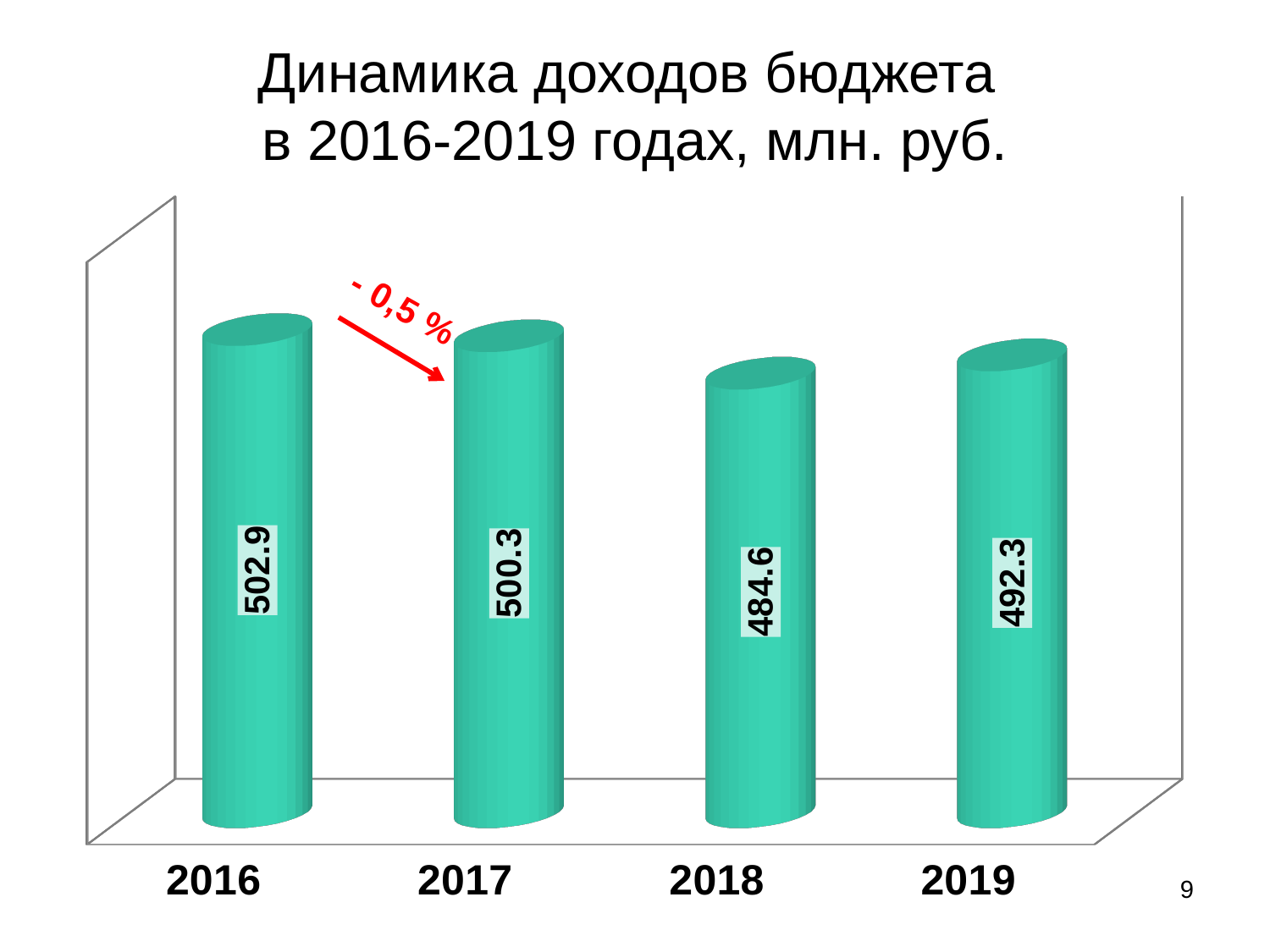
Which year has the highest budget revenue? 2016 Which year has the lowest budget revenue? 2018 What is the difference between the values for 2016 and 2017? 2.6 Which is larger, the value for 2017 or the value for 2019? 2017 What percentage change is written in red next to the arrow between 2016 and 2017? - 0,5 % What is the value shown for 2018? 484.6 Do the values rise or fall from 2016 to 2018? Fall What is the value shown for 2019? 492.3 What is the difference between the values for 2019 and 2018? 7.7 What is the budget revenue value for 2016? 502.9 What kind of chart is shown on the slide? Bar chart How many years are shown on the chart? 4